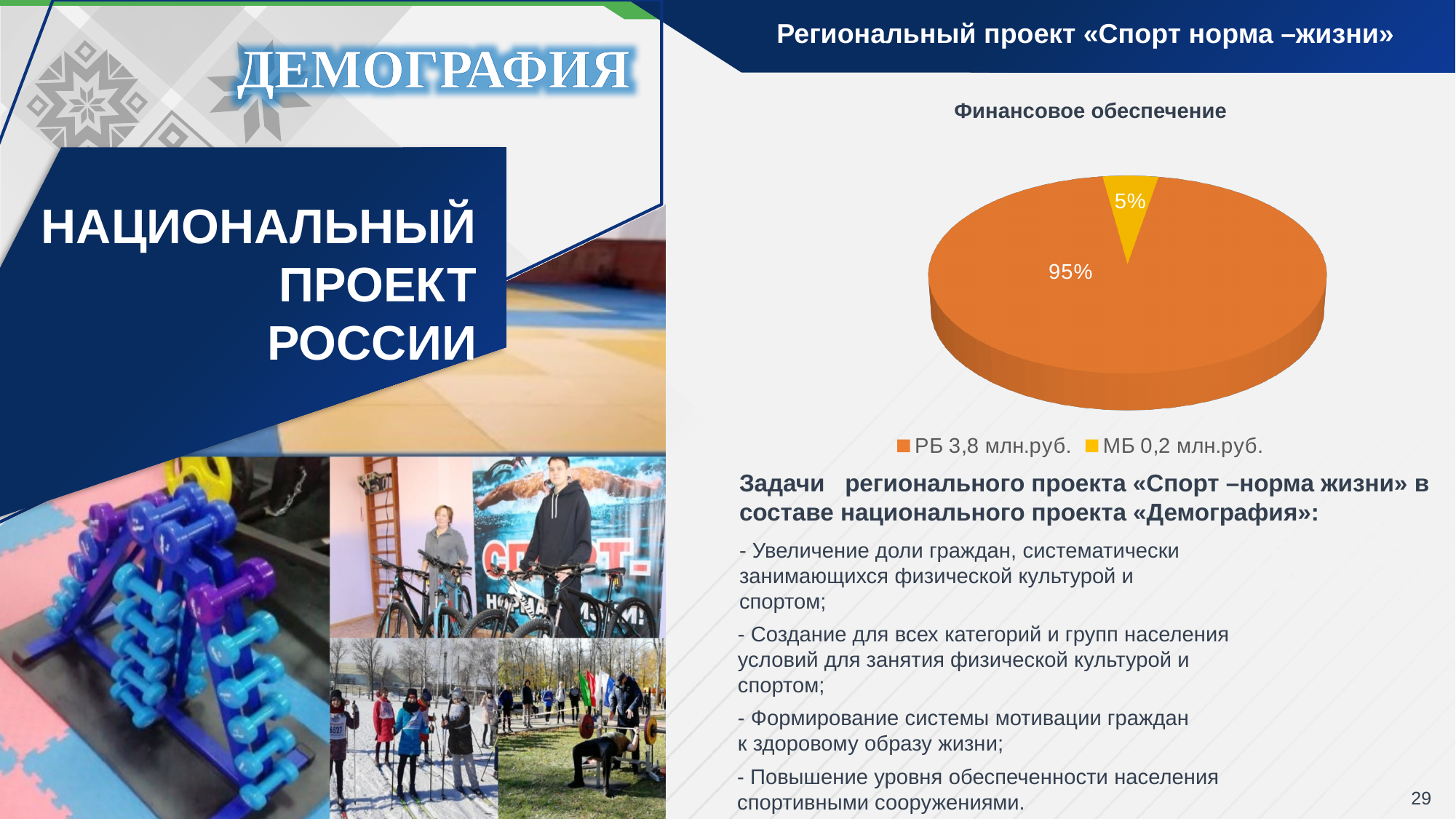
Which slice of the pie is the largest? РБ 3,8 млн.руб. What kind of chart is shown under the title «Финансовое обеспечение»? pie chart Which slice of the pie is the smallest? МБ 0,2 млн.руб. What share of the pie does the slice labelled «МБ 0,2 млн.руб.» take? 5% Which is larger, the share for РБ or the share for МБ? РБ What is the difference in percentage points between the РБ slice and the МБ slice? 90 percentage points How many slices does the pie chart have? 2 What colour is the slice for «МБ 0,2 млн.руб.»? yellow What is the title of the chart? Финансовое обеспечение How many entries does the legend list? 2 What share of the pie does the slice labelled «РБ 3,8 млн.руб.» take? 95%